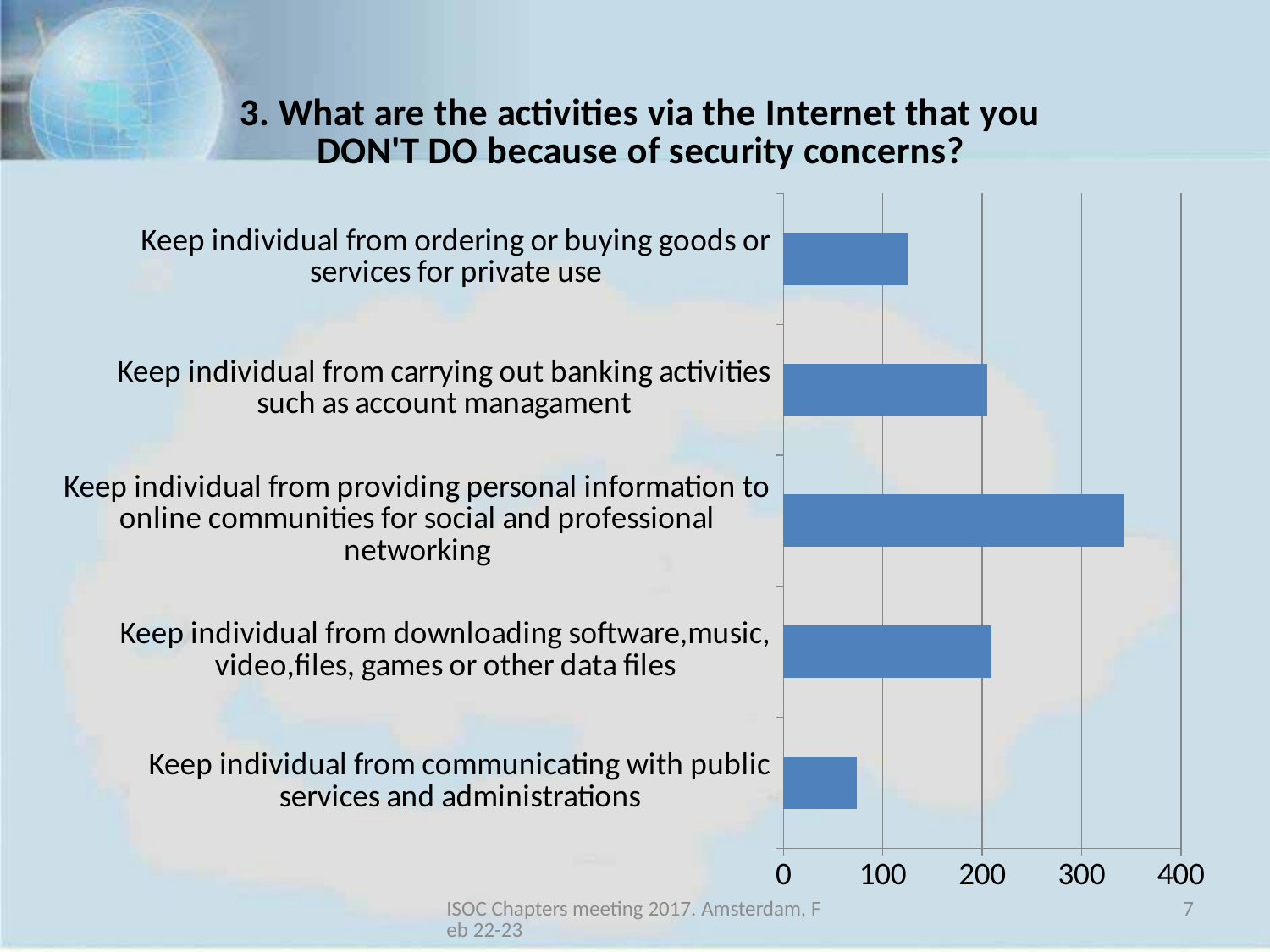
Which activity has the lowest value in the chart? Keep individual from communicating with public services and administrations How many categories (activities) are plotted in the chart? 5 Is the value for 'Keep individual from carrying out banking activities such as account managament' greater or less than 300? less What kind of chart is shown on the slide? bar chart Is the value for 'Keep individual from providing personal information to online communities for social and professional networking' greater or less than 300? greater Is the value for 'Keep individual from communicating with public services and administrations' greater or less than 100? less Which activity has the highest value in the chart? Keep individual from providing personal information to online communities for social and professional networking What is the title of the slide containing the chart? 3. What are the activities via the Internet that you DON'T DO because of security concerns? Which is larger: the value for 'Keep individual from downloading software,music, video,files, games or other data files' or the value for 'Keep individual from communicating with public services and administrations'? Keep individual from downloading software,music, video,files, games or other data files Which is larger: the value for 'Keep individual from ordering or buying goods or services for private use' or the value for 'Keep individual from carrying out banking activities such as account managament'? Keep individual from carrying out banking activities such as account managament What is the maximum value shown on the horizontal axis of the chart? 400